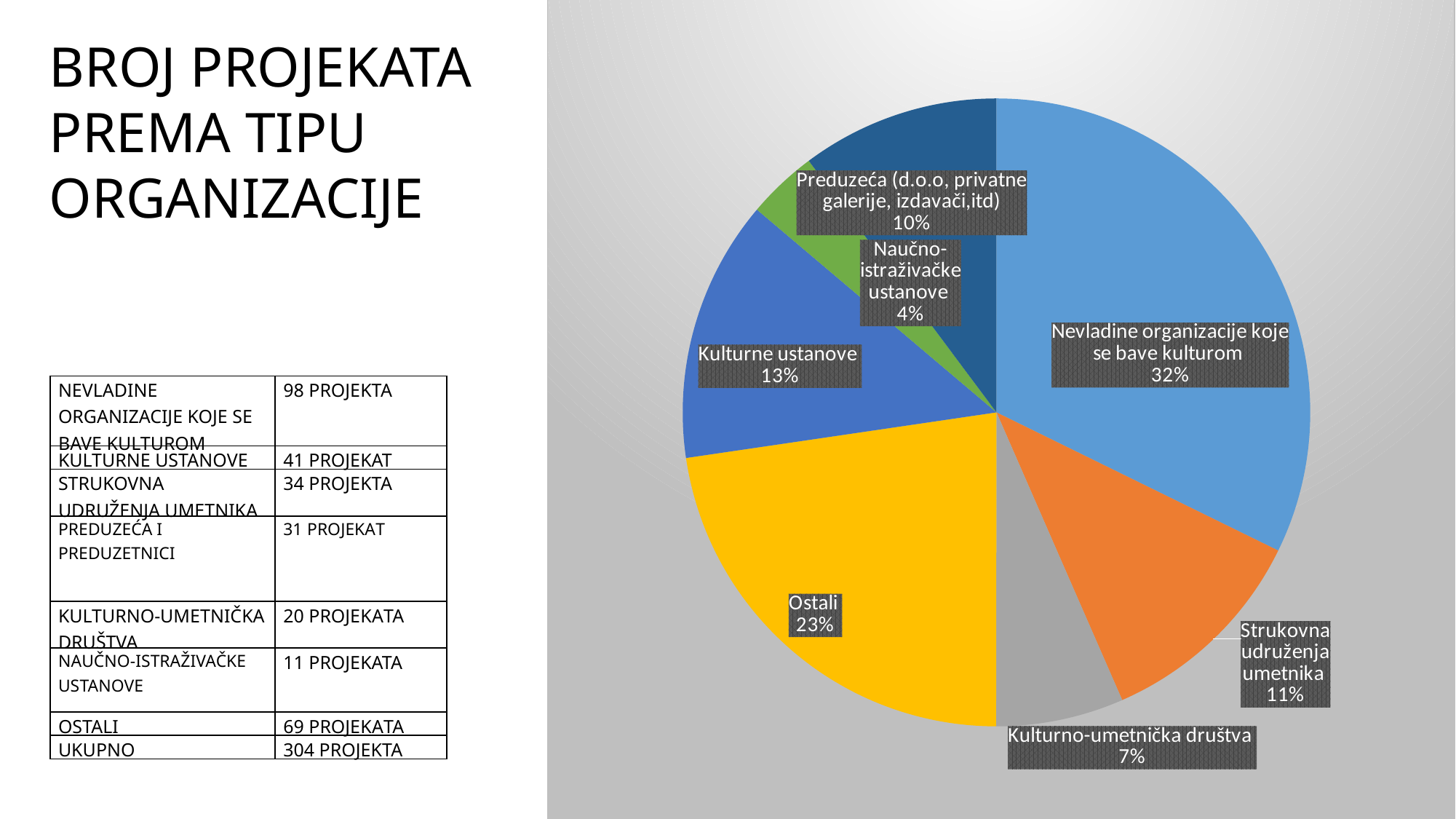
Which category has the smallest slice of the pie? Naučno-istraživačke ustanove Which category has the largest slice of the pie? Nevladine organizacije koje se bave kulturom Which is larger, the slice for "Strukovna udruženja umetnika" or the slice for "Kulturno-umetnička društva"? Strukovna udruženja umetnika What percentage is shown for "Kulturne ustanove"? 13% What kind of chart is shown on the slide? pie chart What percentage is shown for "Strukovna udruženja umetnika"? 11% What share of the pie does "Nevladine organizacije koje se bave kulturom" have? 32% What percentage is shown for "Preduzeća (d.o.o, privatne galerije, izdavači,itd)"? 10% What percentage is shown for "Ostali"? 23% What is the difference in percentage points between "Ostali" and "Kulturne ustanove"? 10 What colour is the slice for "Ostali"? yellow How many slices does the pie chart have? 7